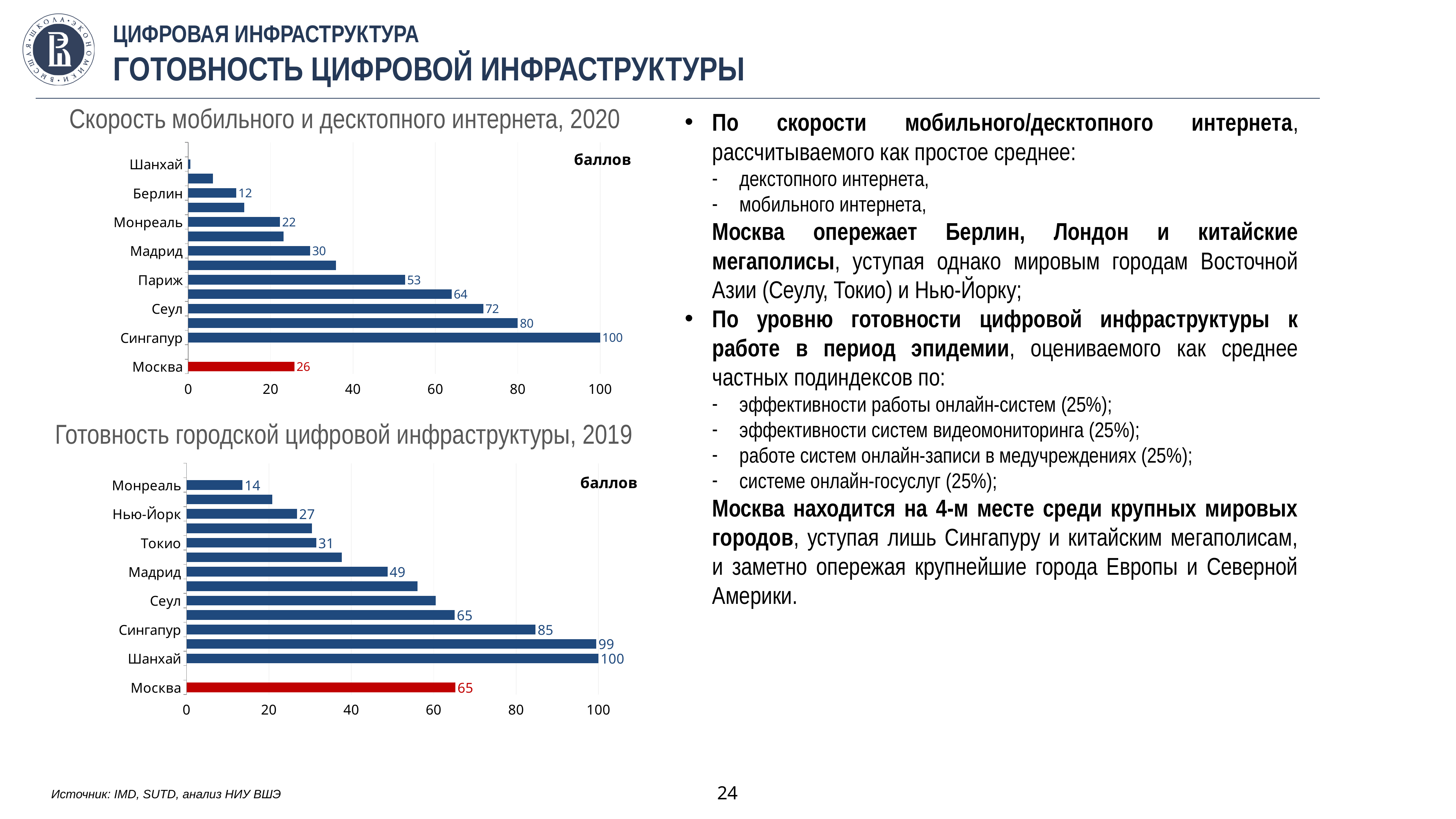
In the chart 'Готовность городской цифровой инфраструктуры, 2019', what is the value for Шанхай? 100 In the chart 'Готовность городской цифровой инфраструктуры, 2019', is the value for Сеул greater or less than 40? greater In the chart 'Скорость мобильного и десктопного интернета, 2020', which city has the highest value? Сингапур In the chart 'Скорость мобильного и десктопного интернета, 2020', what is the value for Москва? 26 In the chart 'Готовность городской цифровой инфраструктуры, 2019', which city has the lowest value? Монреаль In the chart 'Скорость мобильного и десктопного интернета, 2020', which has the larger value, Москва or Берлин? Москва In the chart 'Готовность городской цифровой инфраструктуры, 2019', what is the difference between the values for Сингапур and Москва? 20 In the chart 'Скорость мобильного и десктопного интернета, 2020', what is the value for Сингапур? 100 In the chart 'Готовность городской цифровой инфраструктуры, 2019', what is the value for Москва? 65 In the chart 'Скорость мобильного и десктопного интернета, 2020', what is the difference between the values for Сингапур and Москва? 74 What kind of chart is 'Скорость мобильного и десктопного интернета, 2020'? bar chart In the chart 'Скорость мобильного и десктопного интернета, 2020', which city has the lowest value? Шанхай